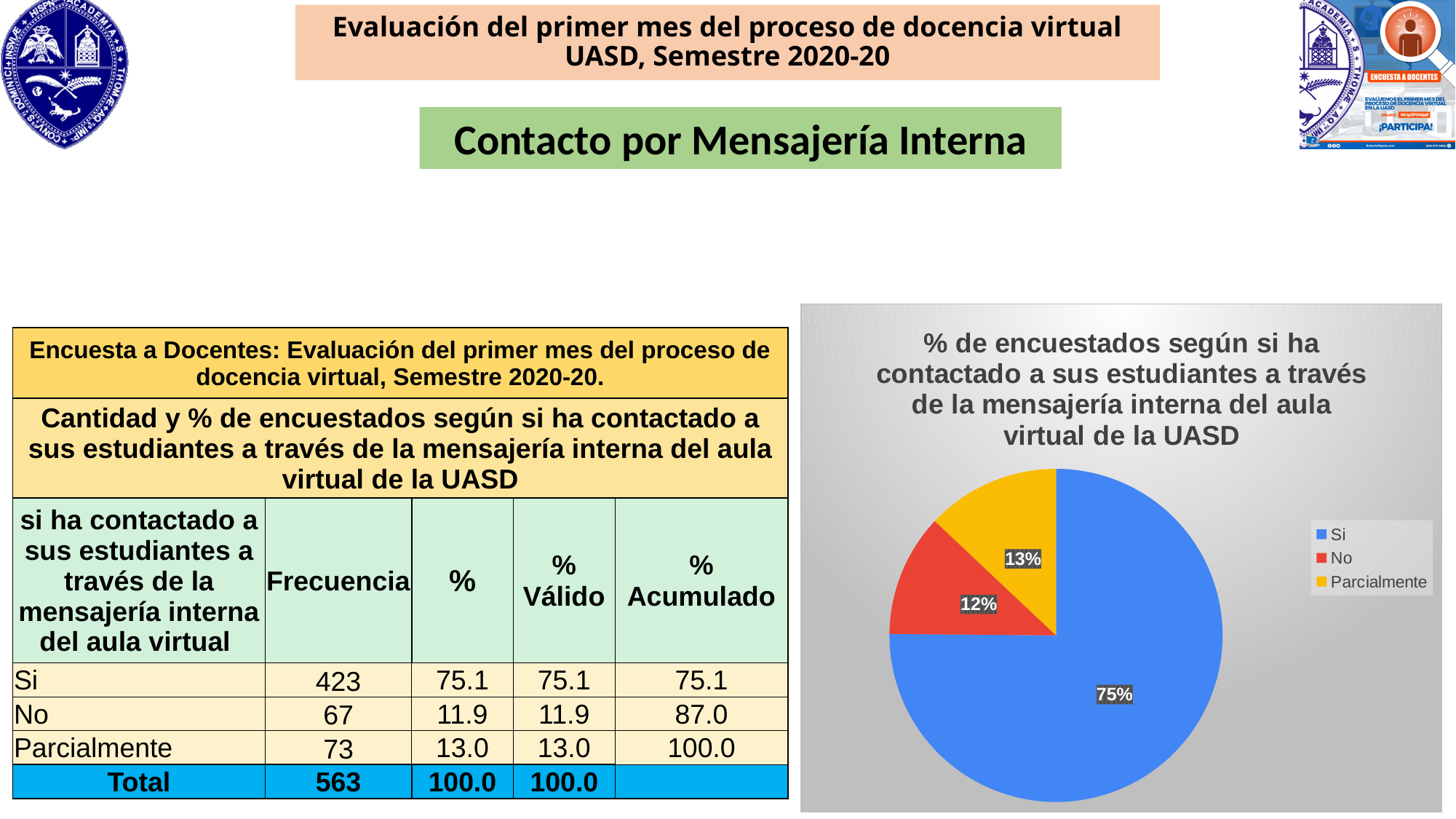
Which category has the largest slice in the pie chart? Si What kind of chart is shown on the slide? pie chart Which slice is larger in the pie chart, 'No' or 'Parcialmente'? Parcialmente Which category has the smallest slice in the pie chart? No What percentage does the 'Parcialmente' slice show in the pie chart? 13% What colour is the 'Parcialmente' slice in the pie chart? yellow What percentage does the 'Si' slice show in the pie chart? 75% What colour is the 'Si' slice in the pie chart? blue What percentage does the 'No' slice show in the pie chart? 12% How many slices does the pie chart have? 3 How many entries does the legend of the pie chart list? 3 What is the difference in percentage points between the 'Si' slice and the 'Parcialmente' slice? 62%